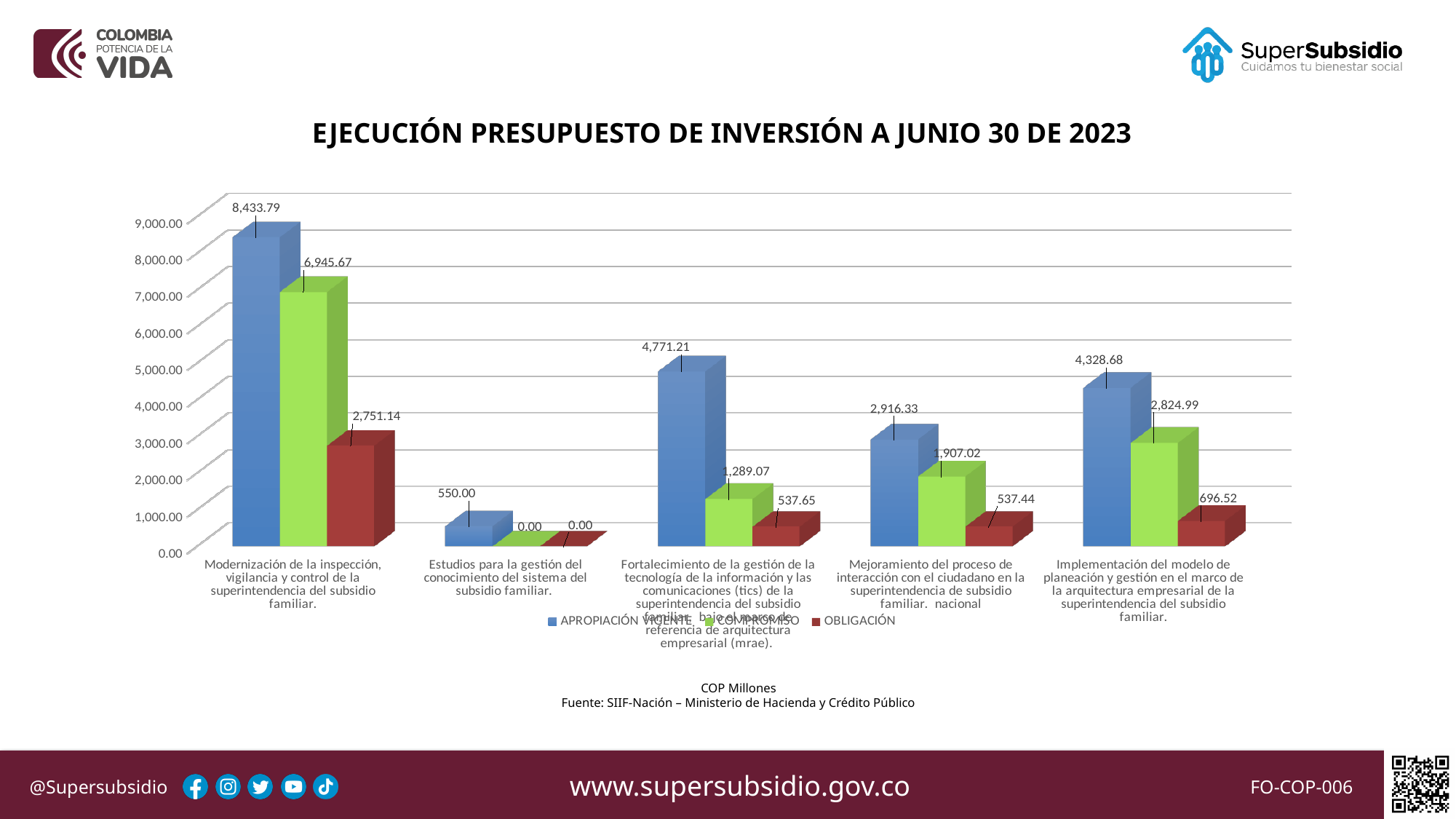
Is the APROPIACIÓN VIGENTE value for 'Implementación del modelo de planeación y gestión' greater or less than 4,000.00? greater What is the difference between APROPIACIÓN VIGENTE and COMPROMISO for 'Modernización de la inspección, vigilancia y control'? 1,488.12 How many categories are shown on the x axis of the chart? 5 What is the COMPROMISO value for 'Estudios para la gestión del conocimiento del sistema del subsidio familiar'? 0.00 What kind of chart is shown on the slide? bar chart Which is larger for 'Mejoramiento del proceso de interacción con el ciudadano': APROPIACIÓN VIGENTE or COMPROMISO? APROPIACIÓN VIGENTE What is the OBLIGACIÓN value for 'Implementación del modelo de planeación y gestión en el marco de la arquitectura empresarial'? 696.52 What is the APROPIACIÓN VIGENTE value for 'Modernización de la inspección, vigilancia y control de la superintendencia del subsidio familiar'? 8,433.79 How many series does the legend list? 3 What is the COMPROMISO value for 'Fortalecimiento de la gestión de la tecnología de la información y las comunicaciones (tics)'? 1,289.07 Which category has the lowest APROPIACIÓN VIGENTE value? Estudios para la gestión del conocimiento del sistema del subsidio familiar Which category has the highest APROPIACIÓN VIGENTE value? Modernización de la inspección, vigilancia y control de la superintendencia del subsidio familiar